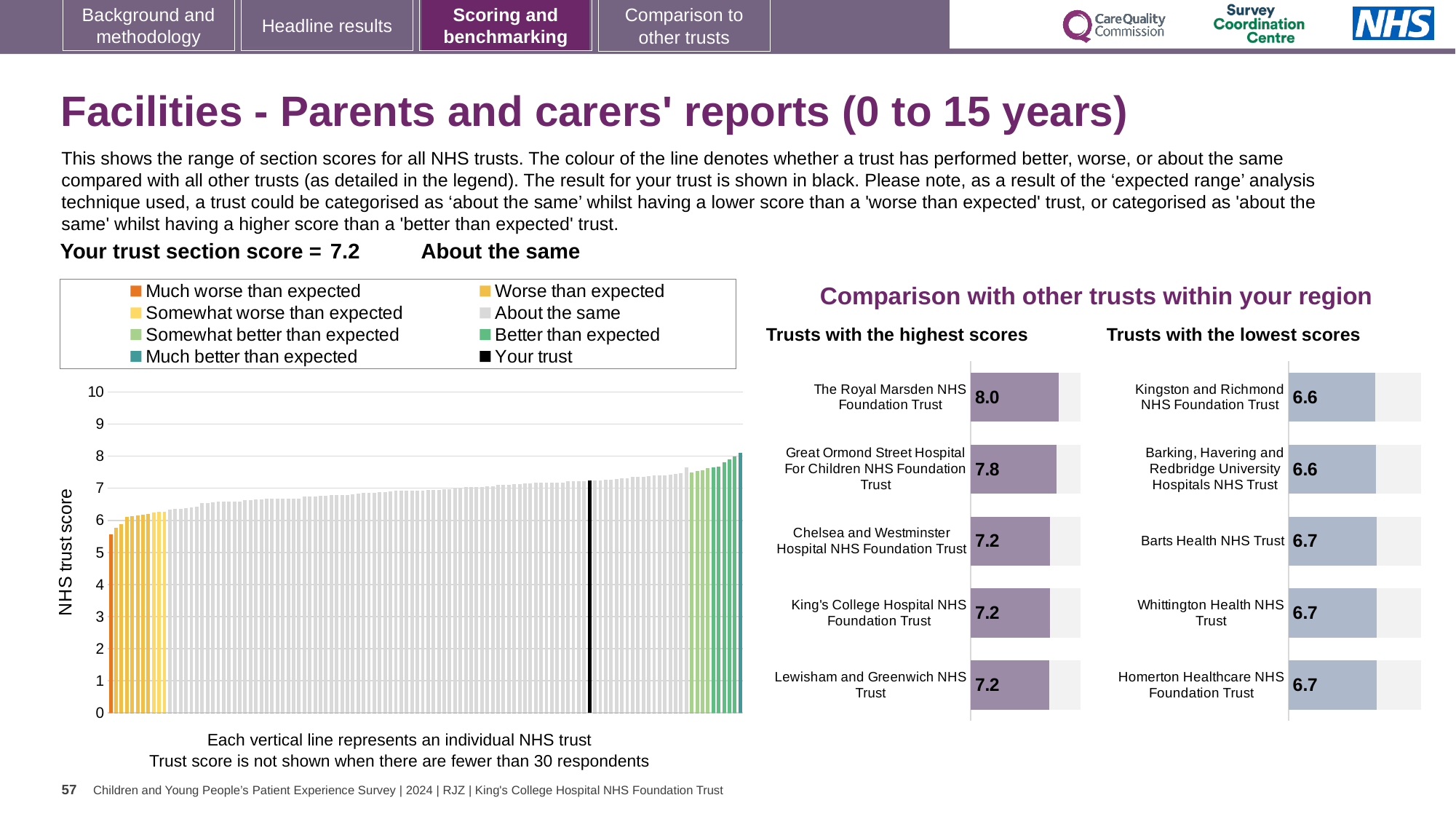
In the 'Trusts with the highest scores' chart, what is the score for The Royal Marsden NHS Foundation Trust? 8.0 In the 'Trusts with the highest scores' chart, which trust has the highest score? The Royal Marsden NHS Foundation Trust In the 'Trusts with the lowest scores' chart, what is the score for Barts Health NHS Trust? 6.7 In the 'Trusts with the highest scores' chart, what is the difference between the scores of The Royal Marsden NHS Foundation Trust and Lewisham and Greenwich NHS Trust? 0.8 In the 'Trusts with the highest scores' chart, what is the score for Great Ormond Street Hospital For Children NHS Foundation Trust? 7.8 How many trusts are shown in the 'Trusts with the lowest scores' chart? 5 In the 'Trusts with the lowest scores' chart, what is the difference between the scores of Barts Health NHS Trust and Kingston and Richmond NHS Foundation Trust? 0.1 In the 'Trusts with the highest scores' chart, which has the larger score: The Royal Marsden NHS Foundation Trust or Great Ormond Street Hospital For Children NHS Foundation Trust? The Royal Marsden NHS Foundation Trust In the large chart on the left, is the value of the leftmost (lowest-scoring) trust greater or less than 6? less How many entries does the legend of the large chart on the left list? 8 In the 'Trusts with the lowest scores' chart, what is the score for Kingston and Richmond NHS Foundation Trust? 6.6 In the large chart on the left, do the trust scores rise or fall from left to right? rise